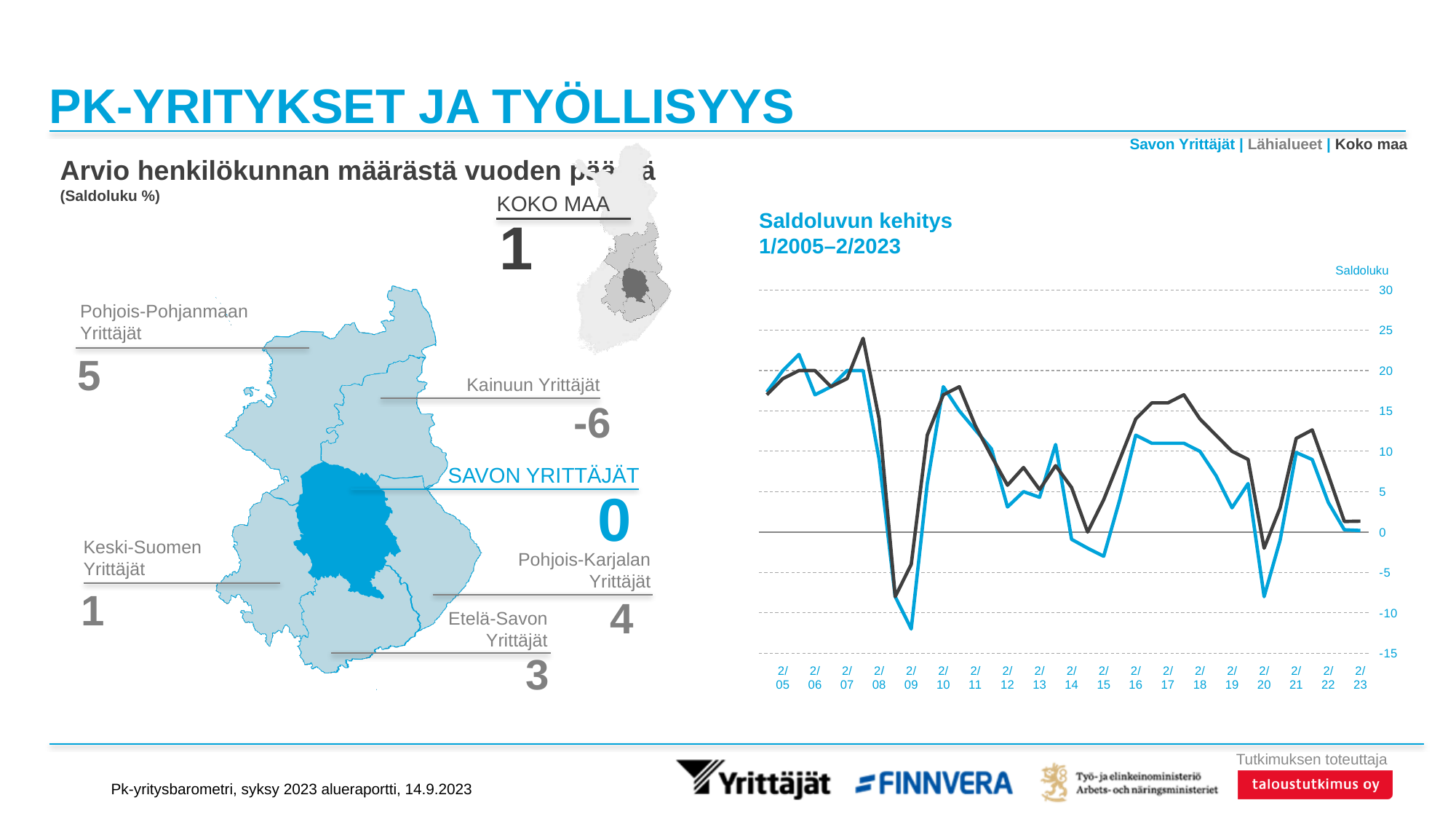
On the map chart, which is larger: the value for Keski-Suomen Yrittäjät or Pohjois-Karjalan Yrittäjät? Pohjois-Karjalan Yrittäjät On the map chart, which region has the lowest value? Kainuun Yrittäjät In the chart 'Saldoluvun kehitys 1/2005–2/2023', is the value of the blue Savon Yrittäjät line at 2/09 greater or less than -10? less In the chart 'Saldoluvun kehitys 1/2005–2/2023', how many x-axis time labels are shown? 19 On the map chart, what is the value shown for Pohjois-Pohjanmaan Yrittäjät? 5 On the map chart, what is the value shown for Kainuun Yrittäjät? -6 What kind of chart is 'Saldoluvun kehitys 1/2005–2/2023'? line chart On the map chart, which region has the highest value? Pohjois-Pohjanmaan Yrittäjät On the map chart, what is the value shown for Koko maa? 1 On the map chart, what is the value shown for Savon Yrittäjät? 0 On the map chart, what is the difference between the values for Pohjois-Karjalan Yrittäjät and Etelä-Savon Yrittäjät? 1 In the chart 'Saldoluvun kehitys 1/2005–2/2023', is the value of the black Koko maa line at 2/08 greater or less than 20? less